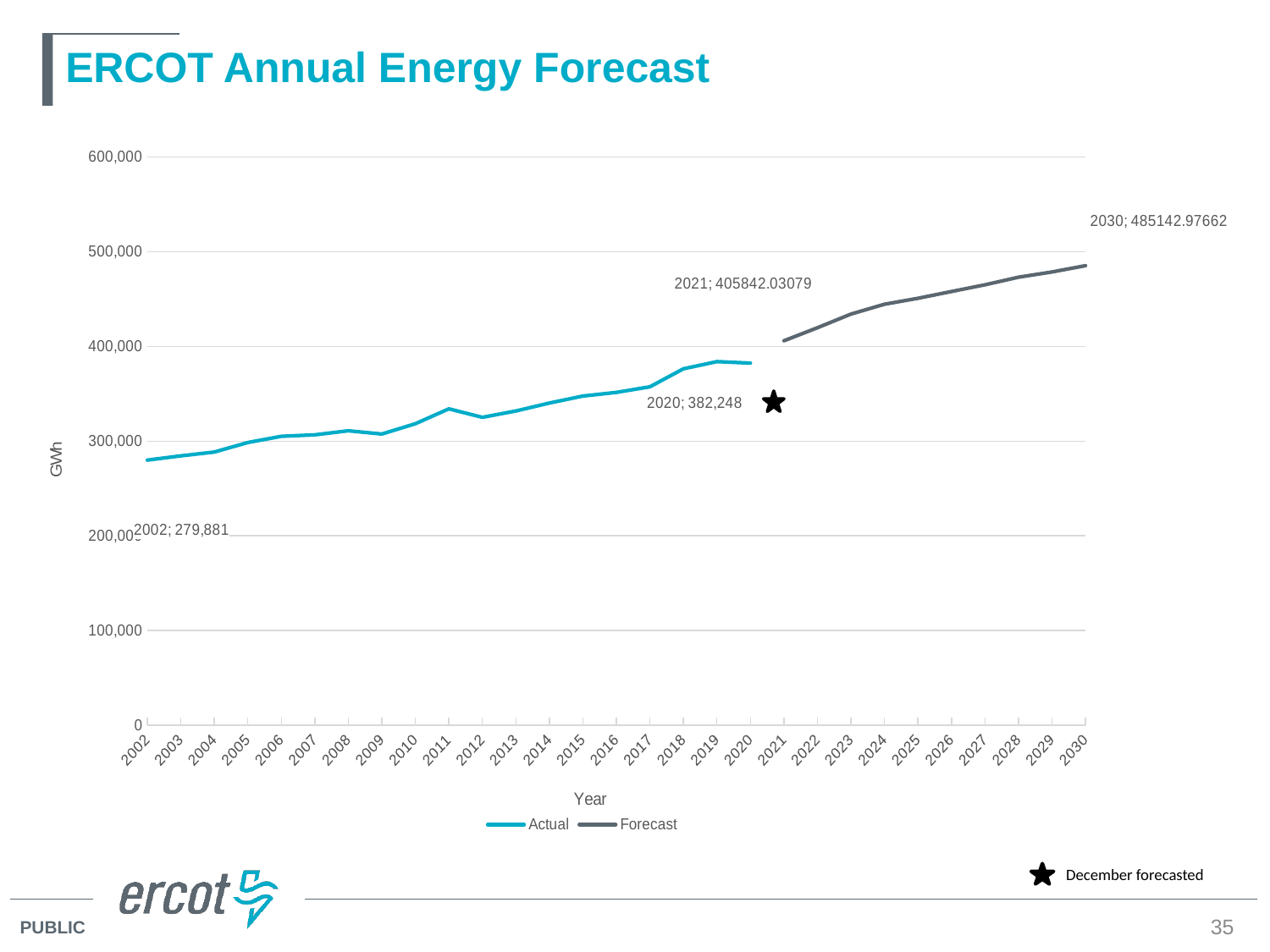
Which year has the highest value on the chart? 2030 Is the value for 2025 greater or less than 400,000? greater What kind of chart is shown on the slide? line chart What is the forecast value labelled for 2030? 485142.97662 How many series does the legend list? 2 What is the difference between the 2020 value and the 2002 value? 102,367 Do the values generally rise or fall from 2002 to 2030? rise What is the value for 2002 on the Actual series? 279,881 What is the value for 2020 on the Actual series? 382,248 What is the forecast value labelled for 2021? 405842.03079 Which year has the lowest value on the chart? 2002 Is the value for 2011 greater or less than 300,000? greater